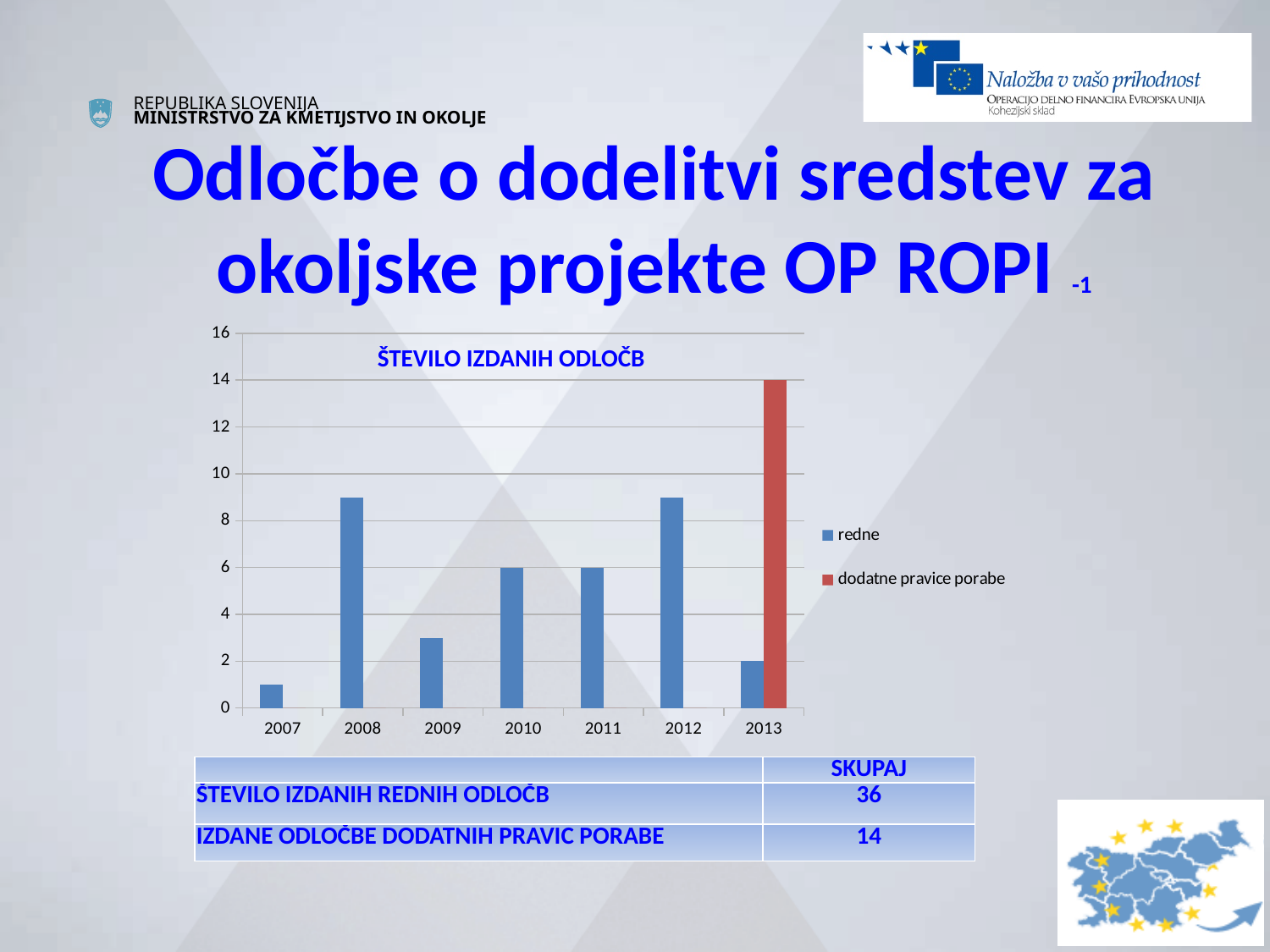
Is the 'redne' value for 2009 greater or less than 4? less How many years are shown on the x axis of the chart? 7 What is the value of the 'dodatne pravice porabe' series for 2013? 14 Which year has the lowest value for the 'redne' series? 2007 What is the title of the chart? ŠTEVILO IZDANIH ODLOČB What kind of chart is shown on the slide? bar chart How many series does the chart legend list? 2 What is the value of the 'redne' series for 2010? 6 Is the 'redne' value for 2008 greater or less than 8? greater What is the value of the 'redne' series for 2013? 2 What is the value of the 'redne' series for 2011? 6 In 2013, what is the difference between the 'dodatne pravice porabe' value and the 'redne' value? 12